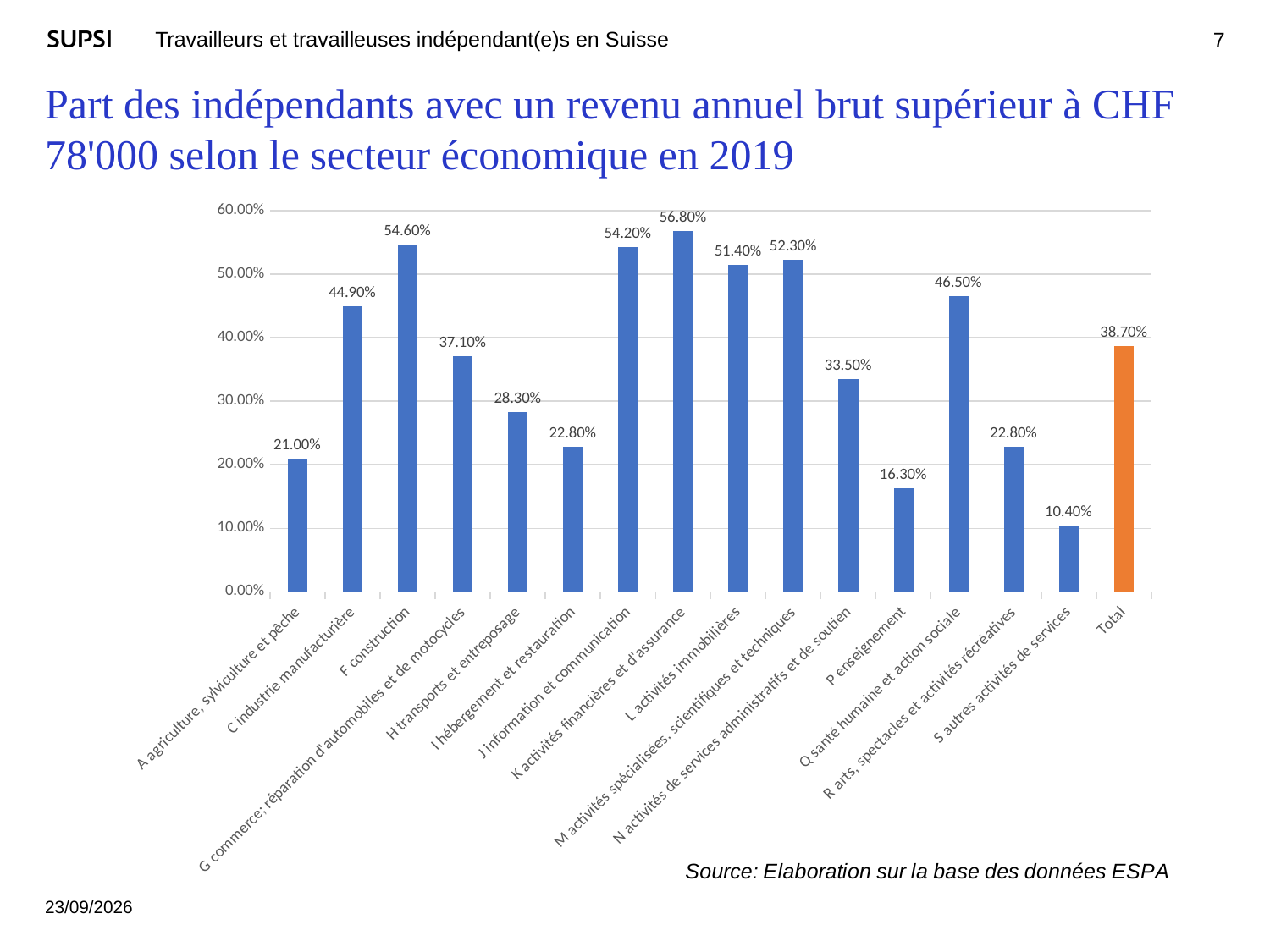
Which bar is shown in orange rather than blue? Total Which sector has the highest share? K activités financières et d'assurance How many bars are shown in the chart, including the Total bar? 16 What is the value for F construction? 54.60% What is the value for Q santé humaine et action sociale? 46.50% What is the value for P enseignement? 16.30% Which sector has the lowest share? S autres activités de services What is the difference between the values for F construction and A agriculture, sylviculture et pêche? 33.60% Which is larger, the value for C industrie manufacturière or the value for G commerce; réparation d'automobiles et de motocycles? C industrie manufacturière What kind of chart is shown on the slide? Bar chart What is the value shown for the Total bar? 38.70% Is the value for N activités de services administratifs et de soutien greater or less than 30.00%? greater